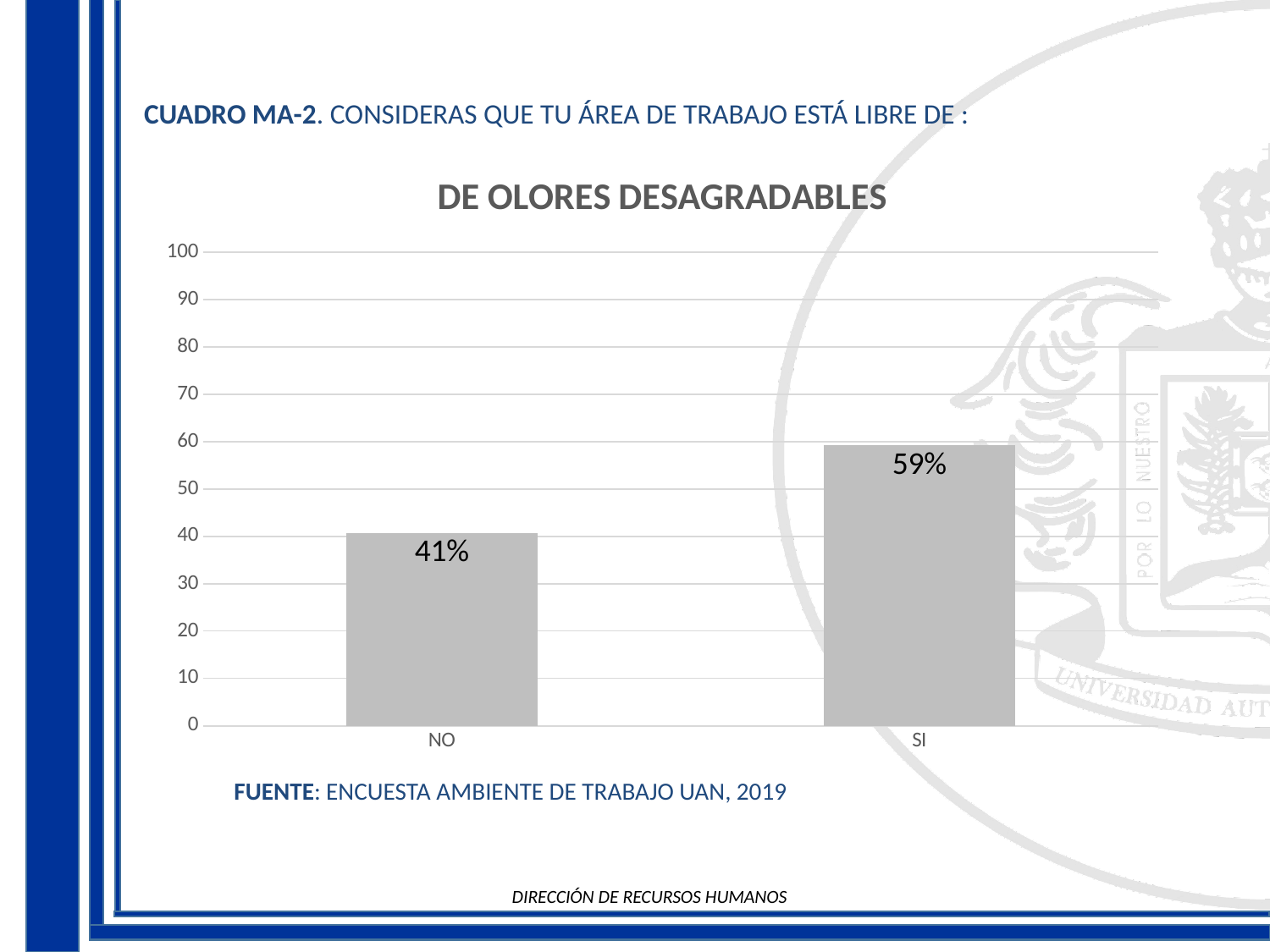
What is the difference between the values for SI and NO? 18% Which category has the highest value? SI What is the value for SI? 59% Is the value for SI greater or less than 50? greater What is the maximum value shown on the y axis? 100 Is the value for NO greater or less than 50? less What is the title of the chart? DE OLORES DESAGRADABLES What is the value for NO? 41% How many categories are shown on the x axis? 2 Which is larger, the value for NO or the value for SI? SI What kind of chart is shown on the slide? bar chart Which category has the lowest value? NO